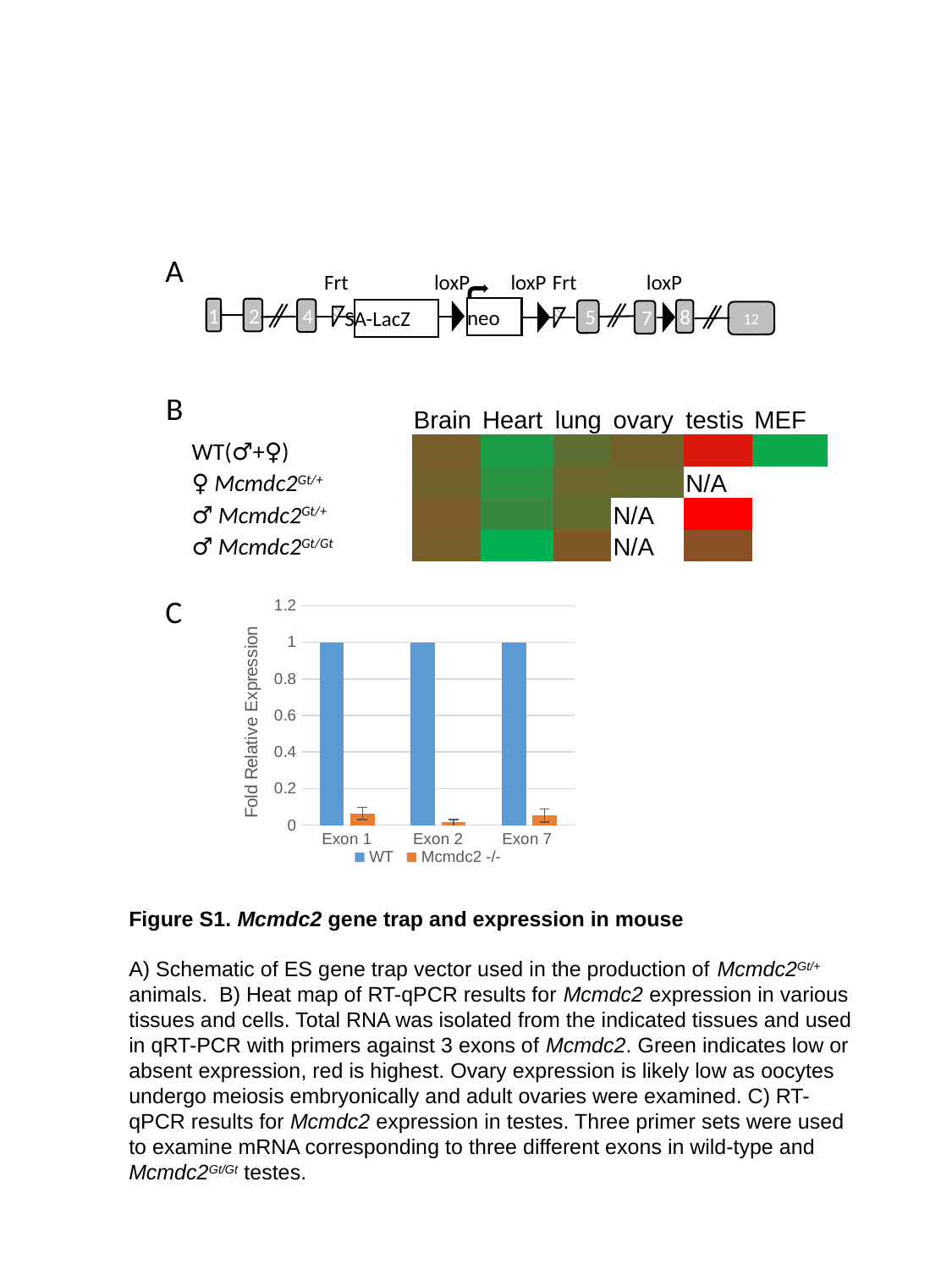
What is the y-axis label of the bar chart in panel C? Fold Relative Expression In the bar chart in panel C, which series has the larger value at Exon 7, WT or Mcmdc2 -/-? WT In the bar chart in panel C, what is the Fold Relative Expression for WT at Exon 7? 1 In the bar chart in panel C, is the value for Mcmdc2 -/- at Exon 1 greater or less than 0.2? less In the bar chart in panel C, which colour represents the WT series? blue In the bar chart in panel C, is the value for WT at Exon 2 greater or less than 0.8? greater How many categories are shown on the x axis of the bar chart in panel C? 3 In the bar chart in panel C, is the value for Mcmdc2 -/- at Exon 2 greater or less than 0.2? less What kind of chart is shown in panel C? bar chart In the bar chart in panel C, what is the Fold Relative Expression for WT at Exon 1? 1 In the bar chart in panel C, which series has the smaller value at Exon 1, WT or Mcmdc2 -/-? Mcmdc2 -/- How many series does the legend of the bar chart in panel C list? 2